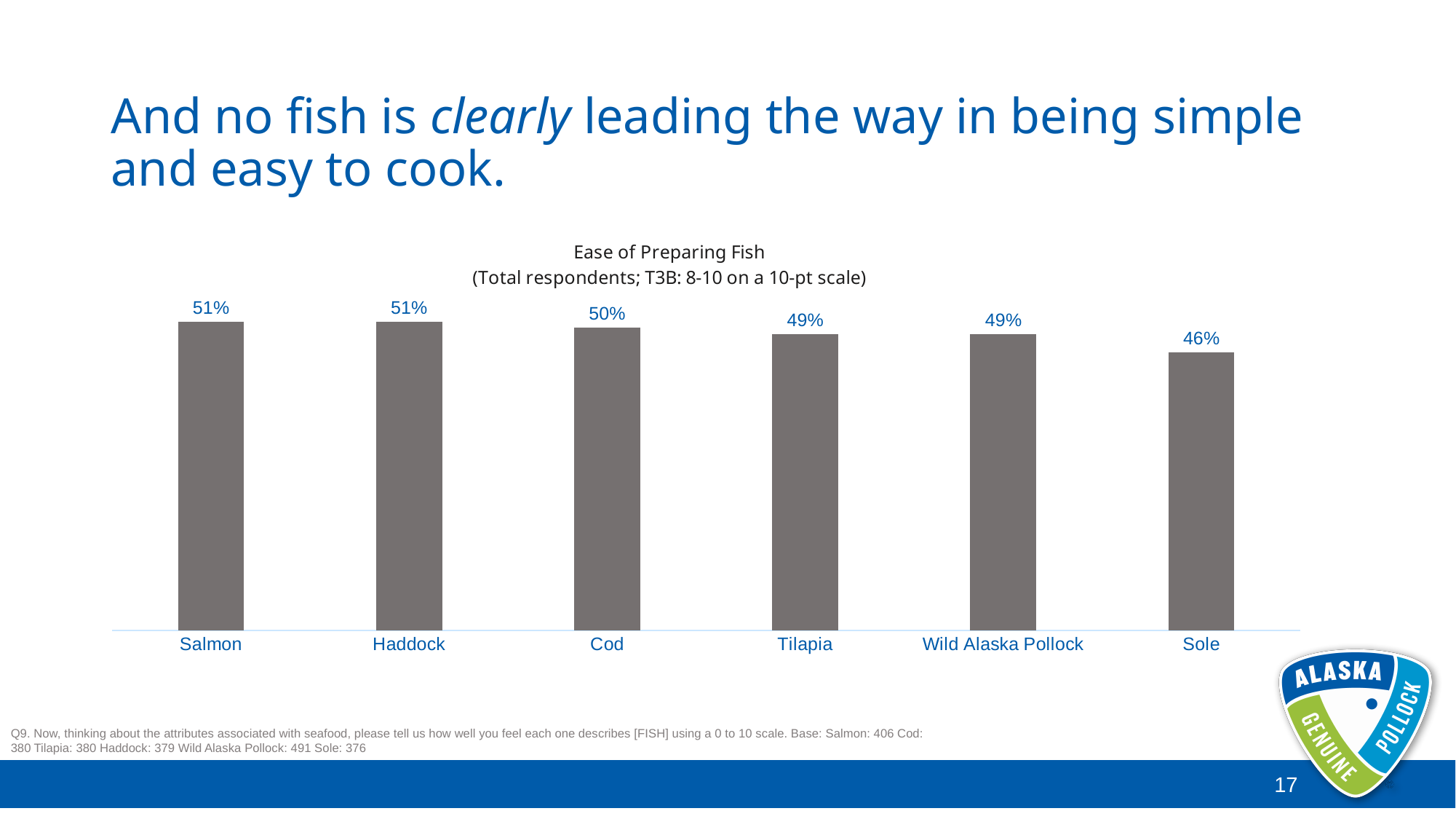
What is the value for Cod? 50% What is the value for Sole? 46% Do the values rise or fall from left to right across the chart? Fall Which fish has the lowest value? Sole What is the difference between the values for Salmon and Sole? 5% What is the difference between the values for Cod and Tilapia? 1% What kind of chart is shown on the slide? Bar chart How many fish categories are shown in the chart? 6 What is the title of the chart? Ease of Preparing Fish What is the value for Salmon? 51% What is the value for Wild Alaska Pollock? 49% Which has a larger value, Haddock or Sole? Haddock